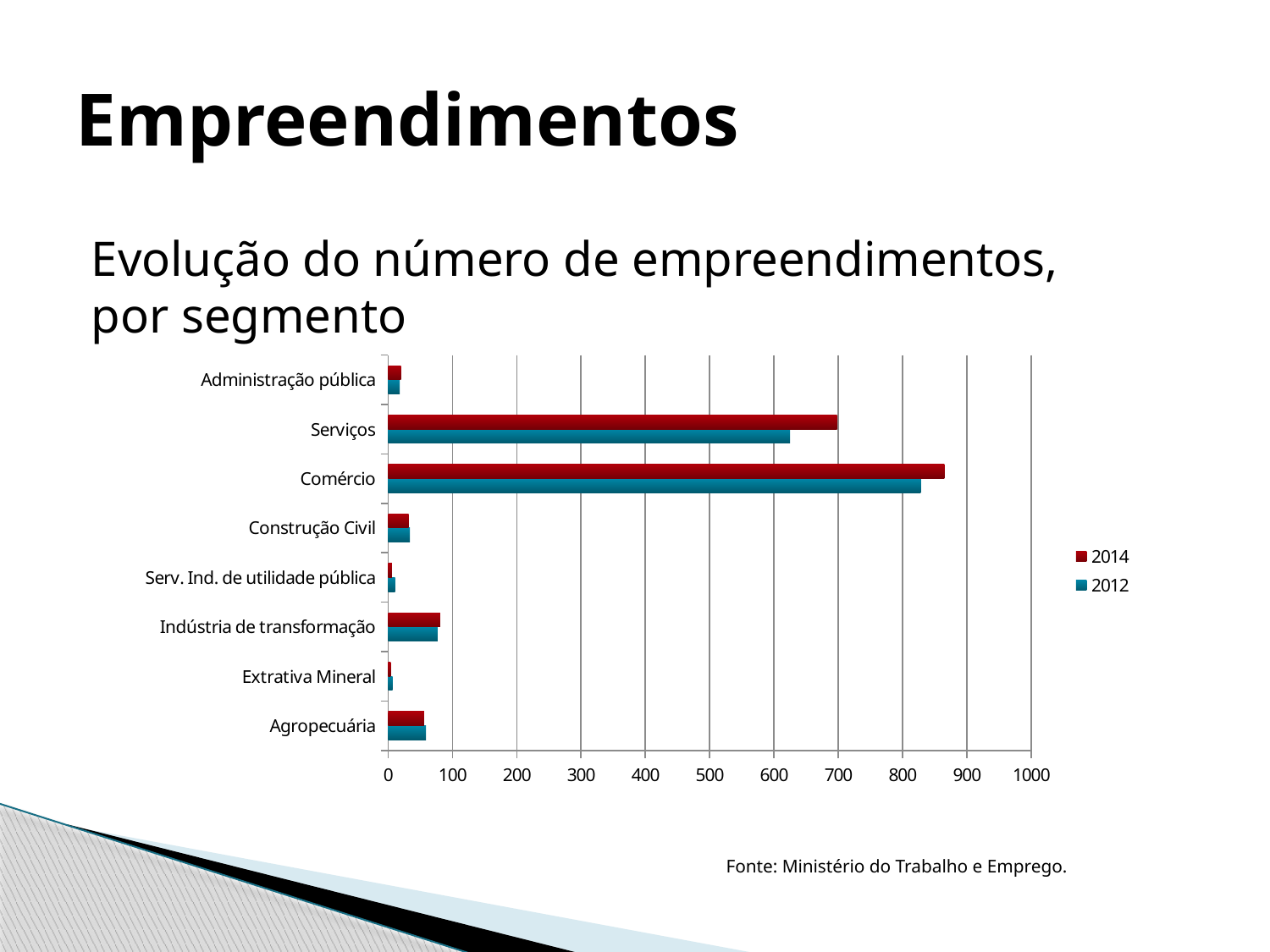
Which segment has the highest value for 2014? Comércio Is the 2012 value for Serviços greater or less than 700? less How many segments (categories) are shown on the chart? 8 Which segment has the lowest value for 2014? Extrativa Mineral Is the 2014 value for Comércio greater or less than 800? greater For Serviços, which year has the larger value, 2014 or 2012? 2014 How many series does the legend list? 2 What kind of chart is shown on the slide? bar chart Which segment has the highest value for 2012? Comércio Which series does the legend list first? 2014 What is the source cited below the chart? Ministério do Trabalho e Emprego Is the 2014 value for Indústria de transformação greater or less than 100? less